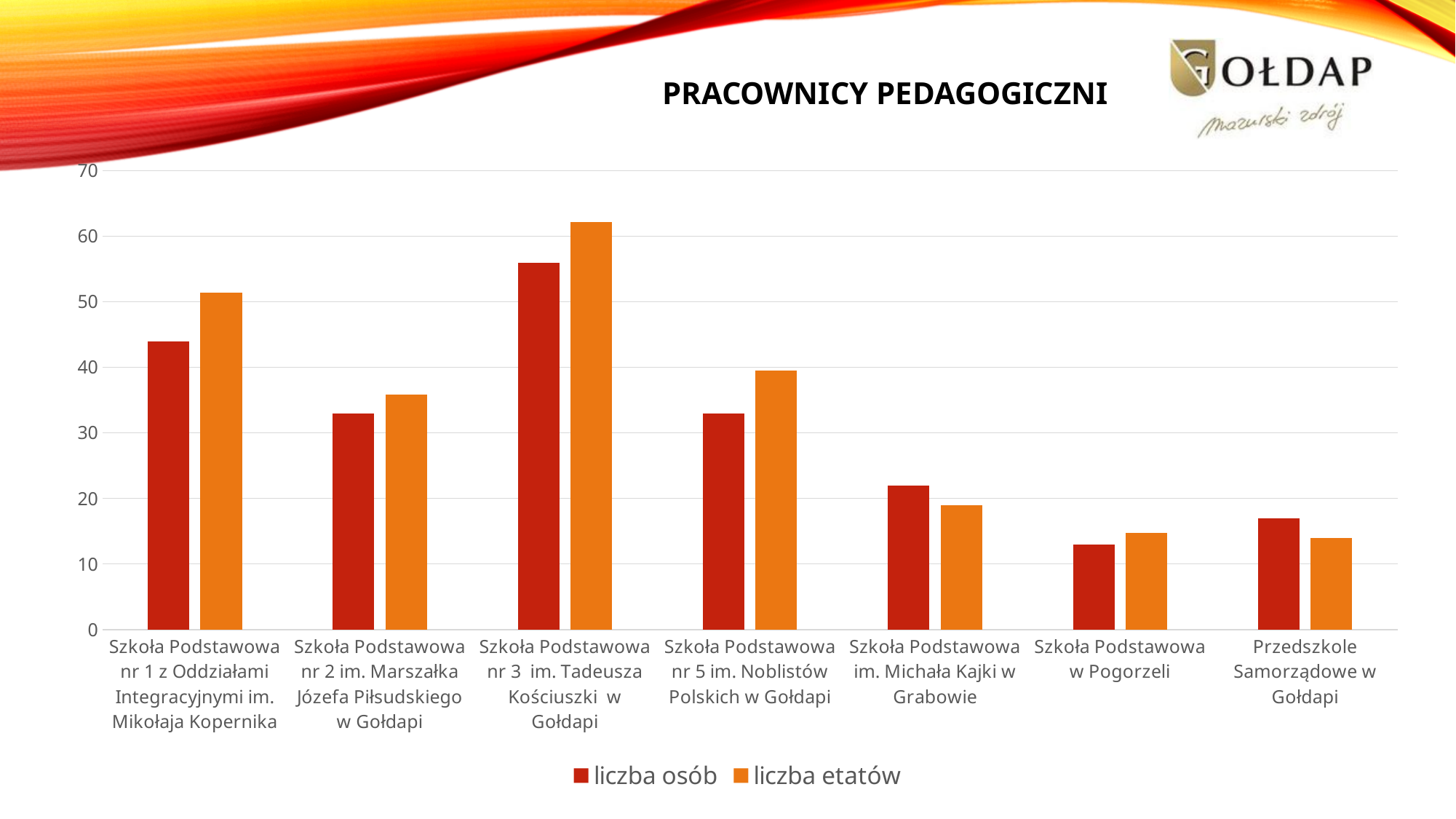
Is the liczba etatów value for Szkoła Podstawowa nr 3 im. Tadeusza Kościuszki w Gołdapi greater or less than 60? greater What kind of chart is shown on the slide? bar chart What is the title of the chart? PRACOWNICY PEDAGOGICZNI Is the liczba osób value for Szkoła Podstawowa nr 1 z Oddziałami Integracyjnymi im. Mikołaja Kopernika greater or less than 40? greater How many schools/institutions are shown on the x axis? 7 Which institution has the highest value for liczba etatów? Szkoła Podstawowa nr 3 im. Tadeusza Kościuszki w Gołdapi Is the liczba etatów value for Przedszkole Samorządowe w Gołdapi greater or less than 20? less For Szkoła Podstawowa nr 1 z Oddziałami Integracyjnymi im. Mikołaja Kopernika, which is larger: liczba osób or liczba etatów? liczba etatów Which institution has the lowest value for liczba osób? Szkoła Podstawowa w Pogorzeli How many series does the legend list? 2 Which institution has the highest value for liczba osób? Szkoła Podstawowa nr 3 im. Tadeusza Kościuszki w Gołdapi For Szkoła Podstawowa im. Michała Kajki w Grabowie, which is larger: liczba osób or liczba etatów? liczba osób